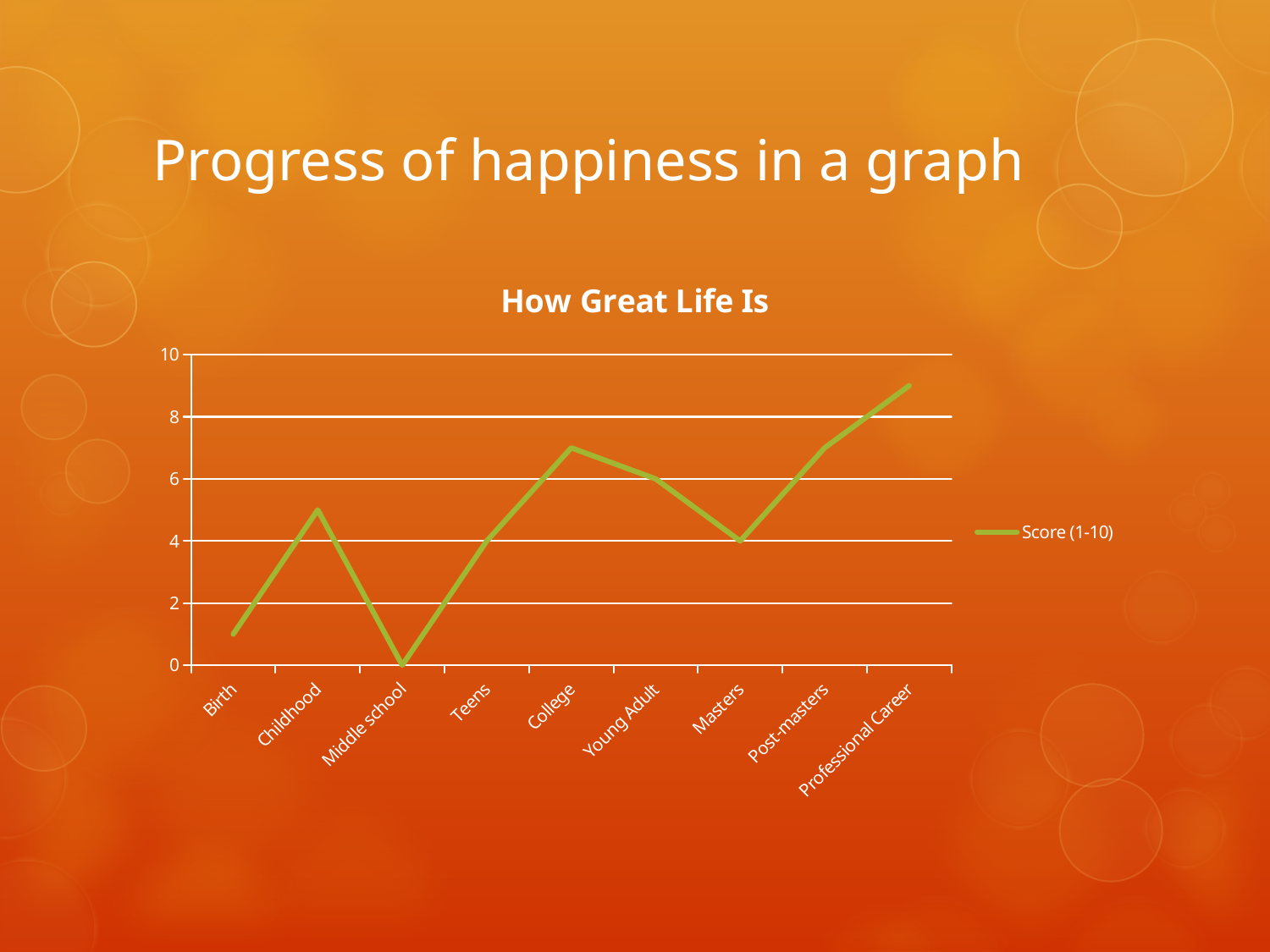
Which life stage has the highest score? Professional Career Which life stage has the lowest score? Middle school Which has the higher score, College or Masters? College What is the title of the chart? How Great Life Is What is the score for Young Adult? 6 What kind of chart is shown on the slide? line chart Is the score for Professional Career greater or less than 8? greater How many life stages are plotted along the x axis? 9 What series does the legend list? Score (1-10) Is the score for Birth greater or less than 2? less What is the score for Middle school? 0 How many series does the legend list? 1